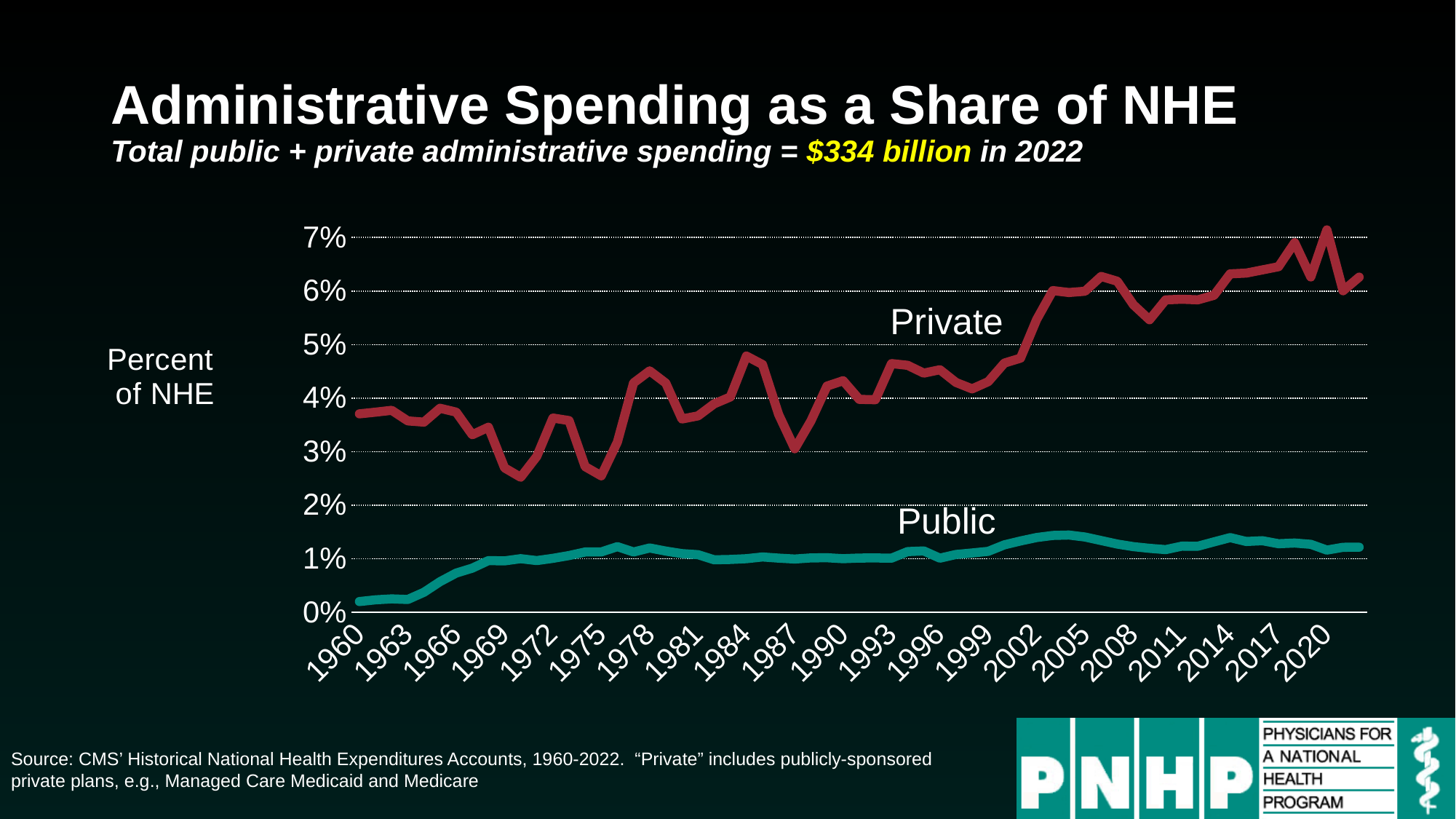
What kind of chart is shown on the slide? line chart Is the value for Private in 2020 greater or less than 5%? greater Is the value for Public in 2020 greater or less than 2%? less What is the label on the vertical axis of the chart? Percent of NHE Is the value for Private in 1960 greater or less than 3%? greater What is the title of the chart? Administrative Spending as a Share of NHE Does the Private series generally rise or fall from 1960 to 2020? rise How many series are plotted on the chart? 2 Which series is higher throughout the chart, Private or Public? Private